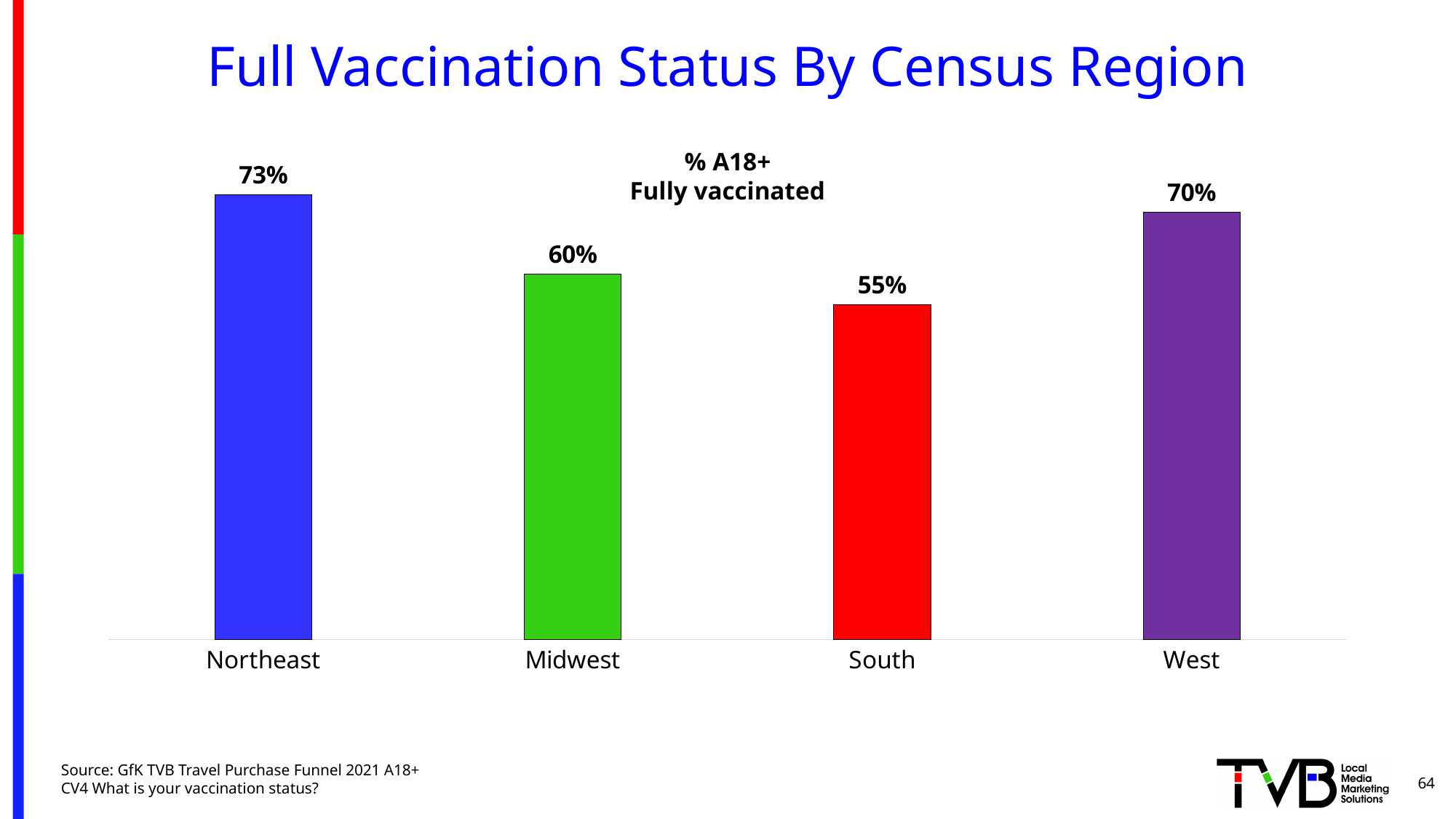
What is the fully vaccinated percentage for the South? 55% What value is shown for the West? 70% Which census region has the highest fully vaccinated percentage? Northeast Which census region has the lowest fully vaccinated percentage? South What is the title of the chart on the slide? Full Vaccination Status By Census Region What is the difference in percentage points between the Northeast and the South? 18 How many census regions are shown in the chart? 4 What colour is the bar for the South? Red What percentage of A18+ in the Northeast are fully vaccinated? 73% What kind of chart is shown on the slide? Bar chart What is the difference in percentage points between the West and the Midwest? 10 Which has a higher fully vaccinated percentage, the Midwest or the West? West